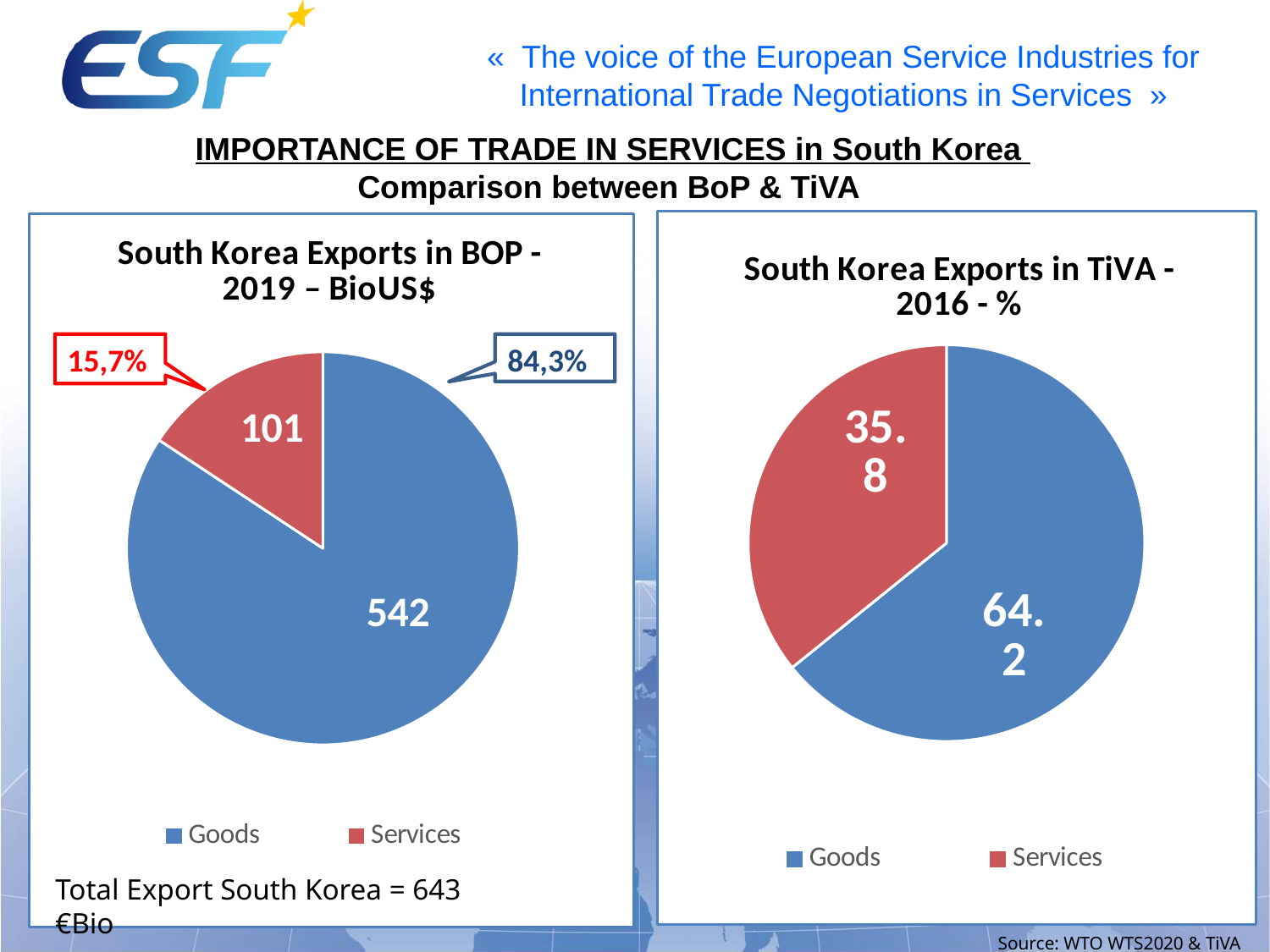
What type of chart is the 'South Korea Exports in TiVA - 2016' chart? Pie chart In the 'South Korea Exports in TiVA - 2016' chart, which category has the smallest slice? Services In the 'South Korea Exports in BOP - 2019' chart, which category has the largest slice? Goods In the 'South Korea Exports in BOP - 2019' chart, what percentage share is shown for Services? 15,7% In the 'South Korea Exports in TiVA - 2016' chart, what is the value for Services? 35.8 In the 'South Korea Exports in BOP - 2019' chart, what is the value for Services? 101 In the 'South Korea Exports in BOP - 2019' chart, what is the value for Goods? 542 How many categories does the legend of the 'South Korea Exports in BOP - 2019' chart list? 2 In the 'South Korea Exports in TiVA - 2016' chart, what is the value for Goods? 64.2 In the 'South Korea Exports in TiVA - 2016' chart, is the value for Goods or Services larger? Goods In the 'South Korea Exports in BOP - 2019' chart, what is the difference between the Goods and Services values? 441 In the 'South Korea Exports in BOP - 2019' chart, what percentage share is shown for Goods? 84,3%